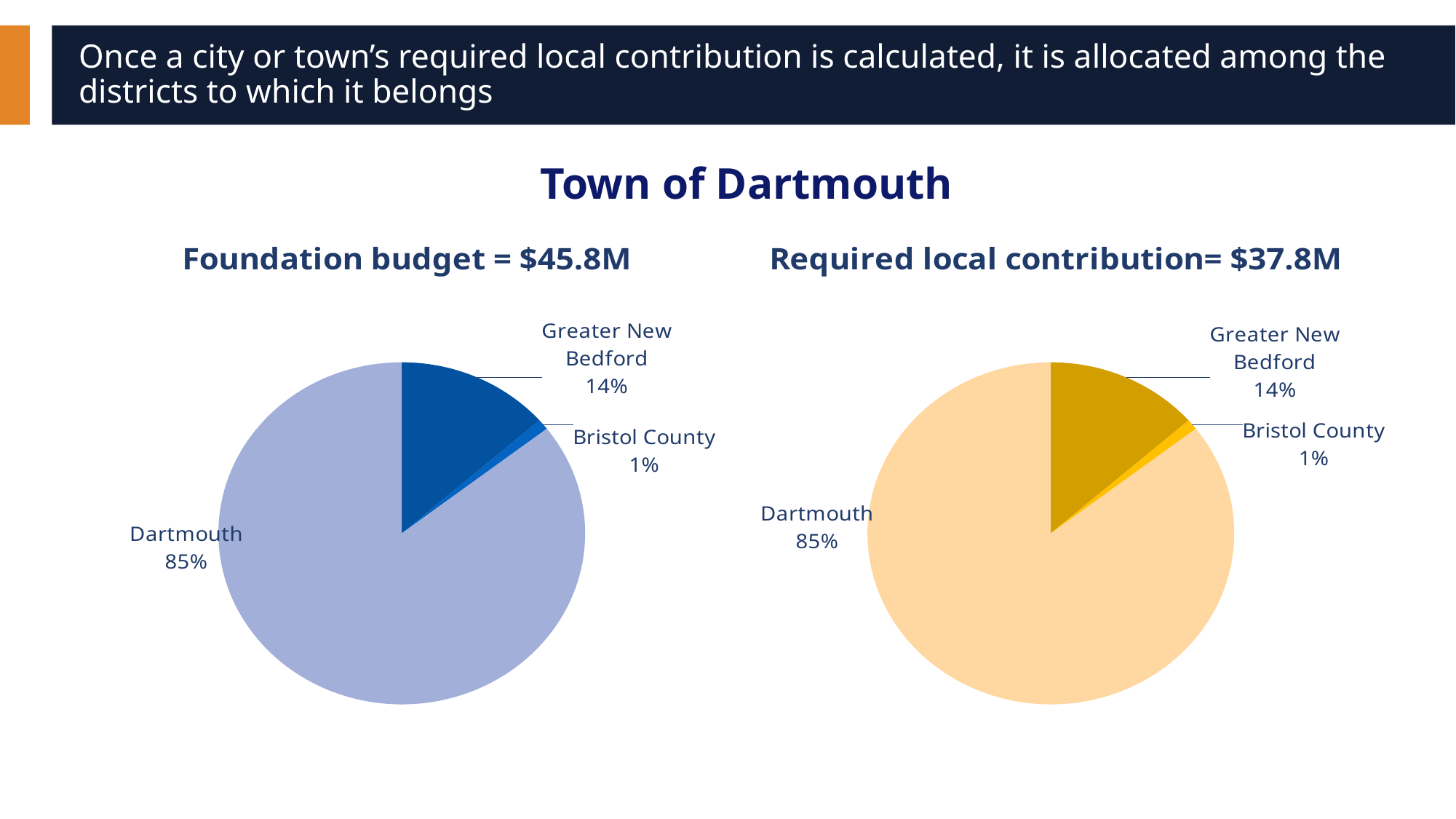
In the 'Required local contribution= $37.8M' chart, what share does Dartmouth have? 85% In the 'Foundation budget = $45.8M' chart, which district has the largest slice? Dartmouth Which town do the two charts on the slide describe? Town of Dartmouth What kind of chart is the 'Required local contribution= $37.8M' chart? Pie chart In the 'Foundation budget = $45.8M' chart, what share does Greater New Bedford have? 14% In the 'Required local contribution= $37.8M' chart, what share does Bristol County have? 1% In the 'Required local contribution= $37.8M' chart, which is larger, Greater New Bedford or Bristol County? Greater New Bedford In the 'Foundation budget = $45.8M' chart, what is the difference in percentage points between Dartmouth and Greater New Bedford? 71 In the 'Required local contribution= $37.8M' chart, which district has the smallest slice? Bristol County How many slices does the 'Foundation budget = $45.8M' chart have? 3 What is the title of the chart on the left of the slide? Foundation budget = $45.8M